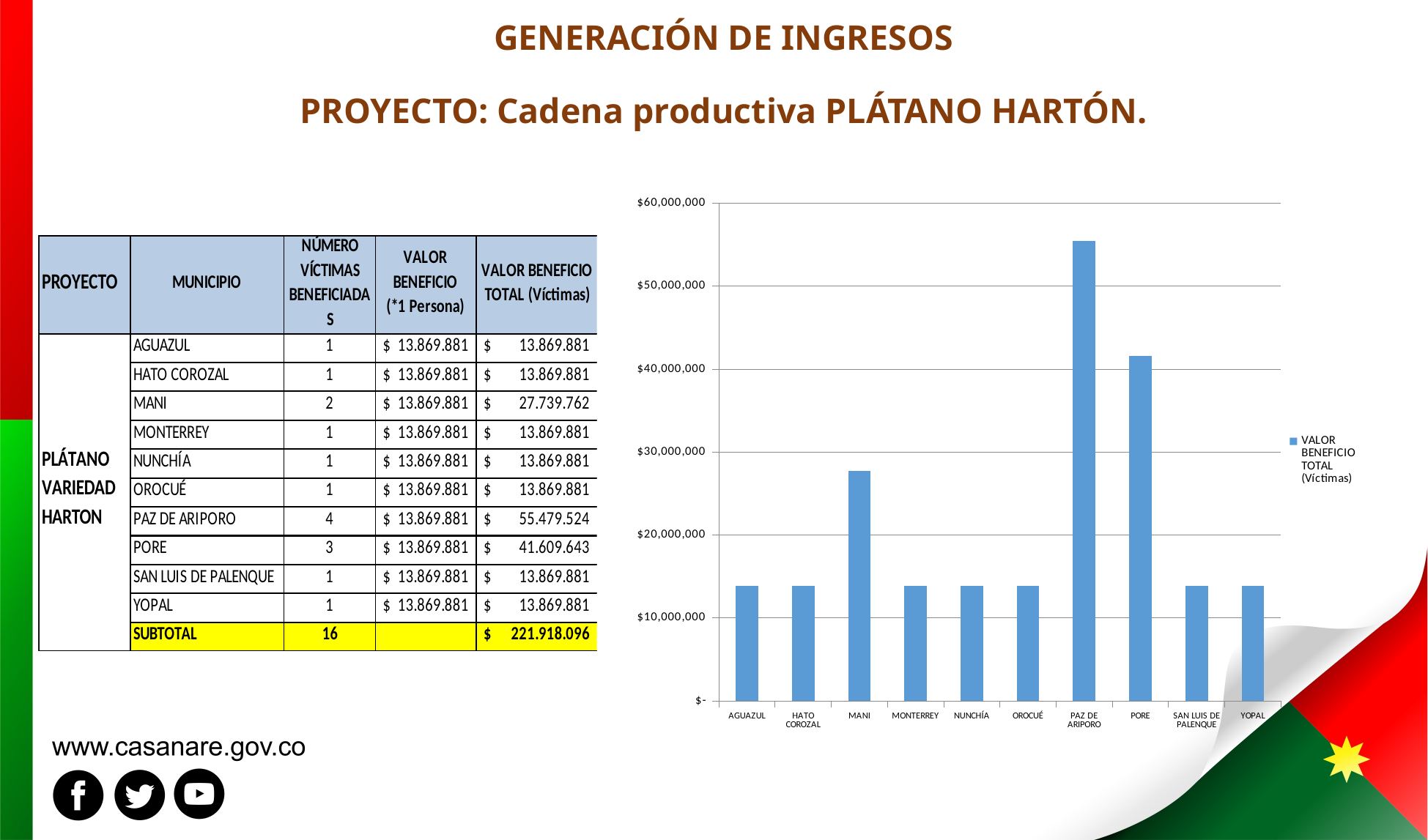
How many series does the chart's legend list? 1 How many municipalities are plotted on the x axis of the chart? 10 Is the value for PORE greater or less than $30,000,000? greater Is the value for MANI greater or less than $30,000,000? less Which has the larger value in the chart, PORE or MANI? PORE What series name does the chart's legend show? VALOR BENEFICIO TOTAL (Víctimas) Which municipality has the highest bar in the chart? PAZ DE ARIPORO Is the value for AGUAZUL greater or less than $10,000,000? greater Which has the larger value in the chart, PAZ DE ARIPORO or PORE? PAZ DE ARIPORO What kind of chart is shown on the slide? bar chart